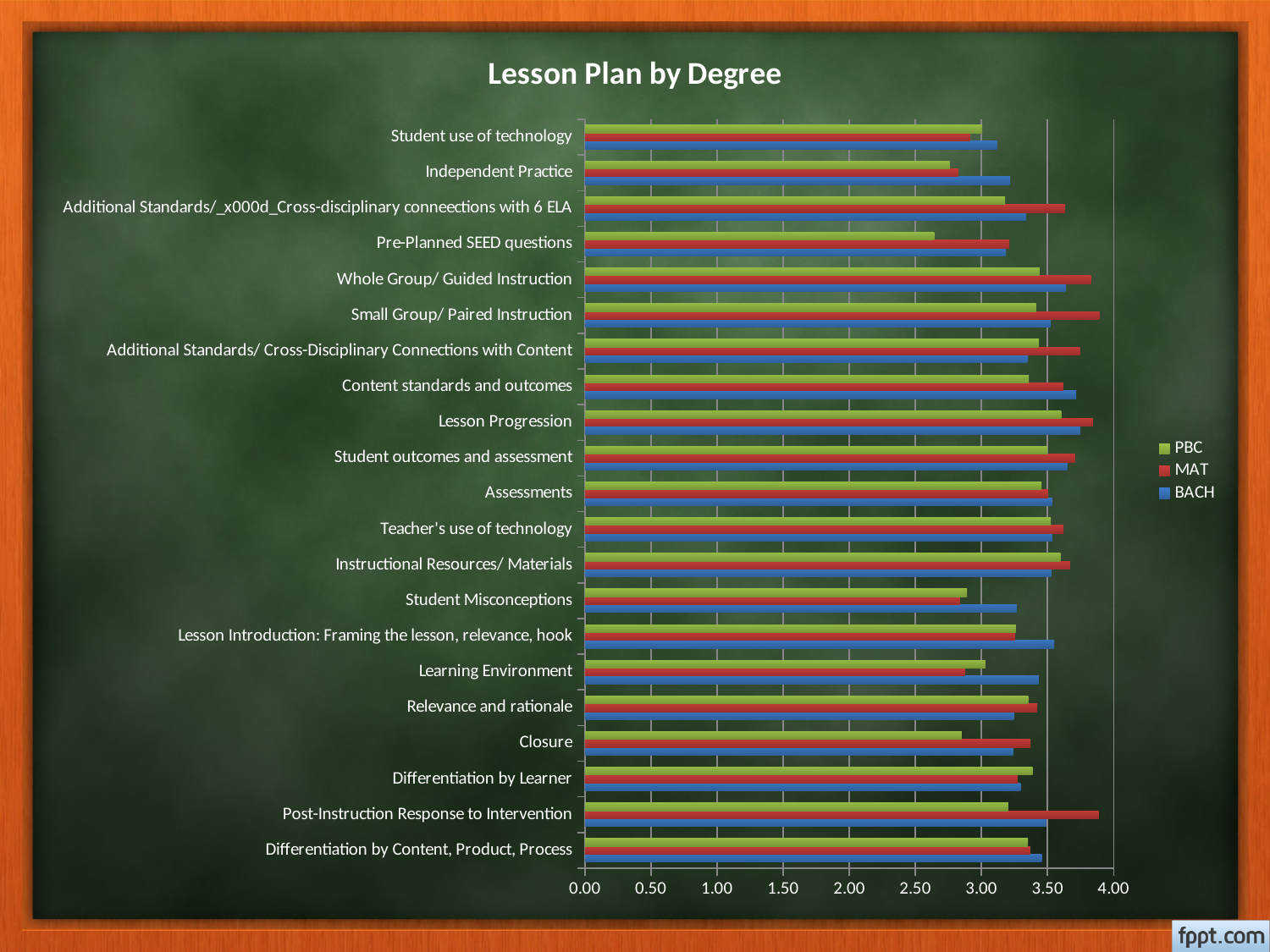
For Post-Instruction Response to Intervention, which is larger: the MAT value or the PBC value? MAT How many categories are plotted on the vertical axis? 21 Is the MAT value for Independent Practice greater or less than 3.00? less What is the title of the chart? Lesson Plan by Degree How many series does the legend list? 3 What type of chart is shown on the slide? bar chart Is the MAT value for Small Group/ Paired Instruction greater or less than 3.50? greater Which series is shown in red in the legend? MAT Is the PBC value for Pre-Planned SEED questions greater or less than 3.00? less For Pre-Planned SEED questions, which is larger: the BACH value or the PBC value? BACH For Whole Group/ Guided Instruction, which is larger: the MAT value or the PBC value? MAT